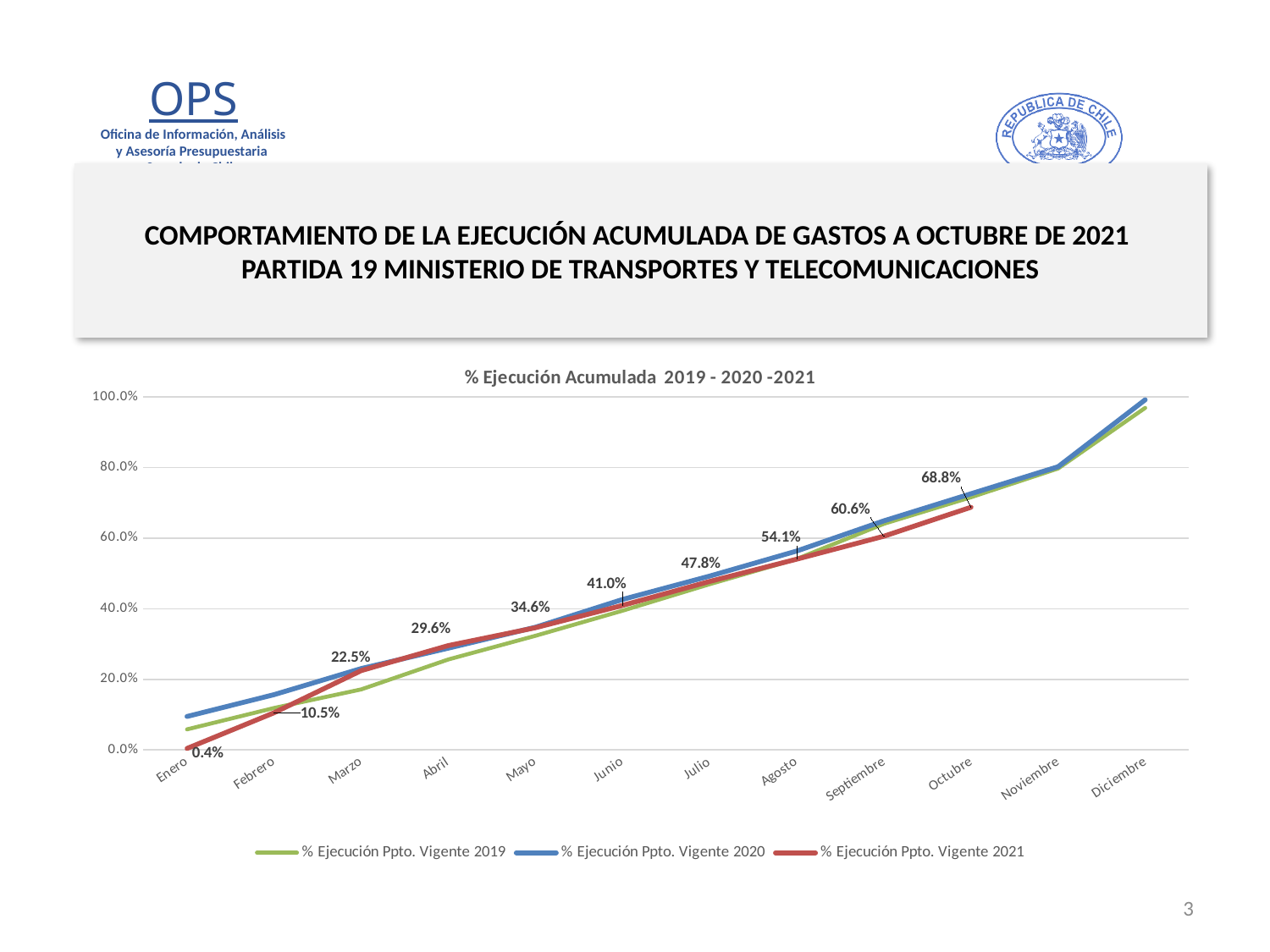
What is the difference between the 2021 values for Agosto and Julio? 6.3% Is the value for % Ejecución Ppto. Vigente 2020 in Diciembre greater or less than 80.0%? greater What kind of chart is shown? Line chart In which month does the % Ejecución Ppto. Vigente 2021 series have its lowest value? Enero What is the difference between the 2021 values for Octubre and Septiembre? 8.2% What is the value for % Ejecución Ppto. Vigente 2021 in Marzo? 22.5% How many months are shown on the x axis? 12 What is the value for % Ejecución Ppto. Vigente 2021 in Junio? 41.0% What is the value for % Ejecución Ppto. Vigente 2021 in Octubre? 68.8% What is the value for % Ejecución Ppto. Vigente 2021 in Enero? 0.4% How many series does the legend list? 3 In which month does the % Ejecución Ppto. Vigente 2021 series reach its highest value? Octubre